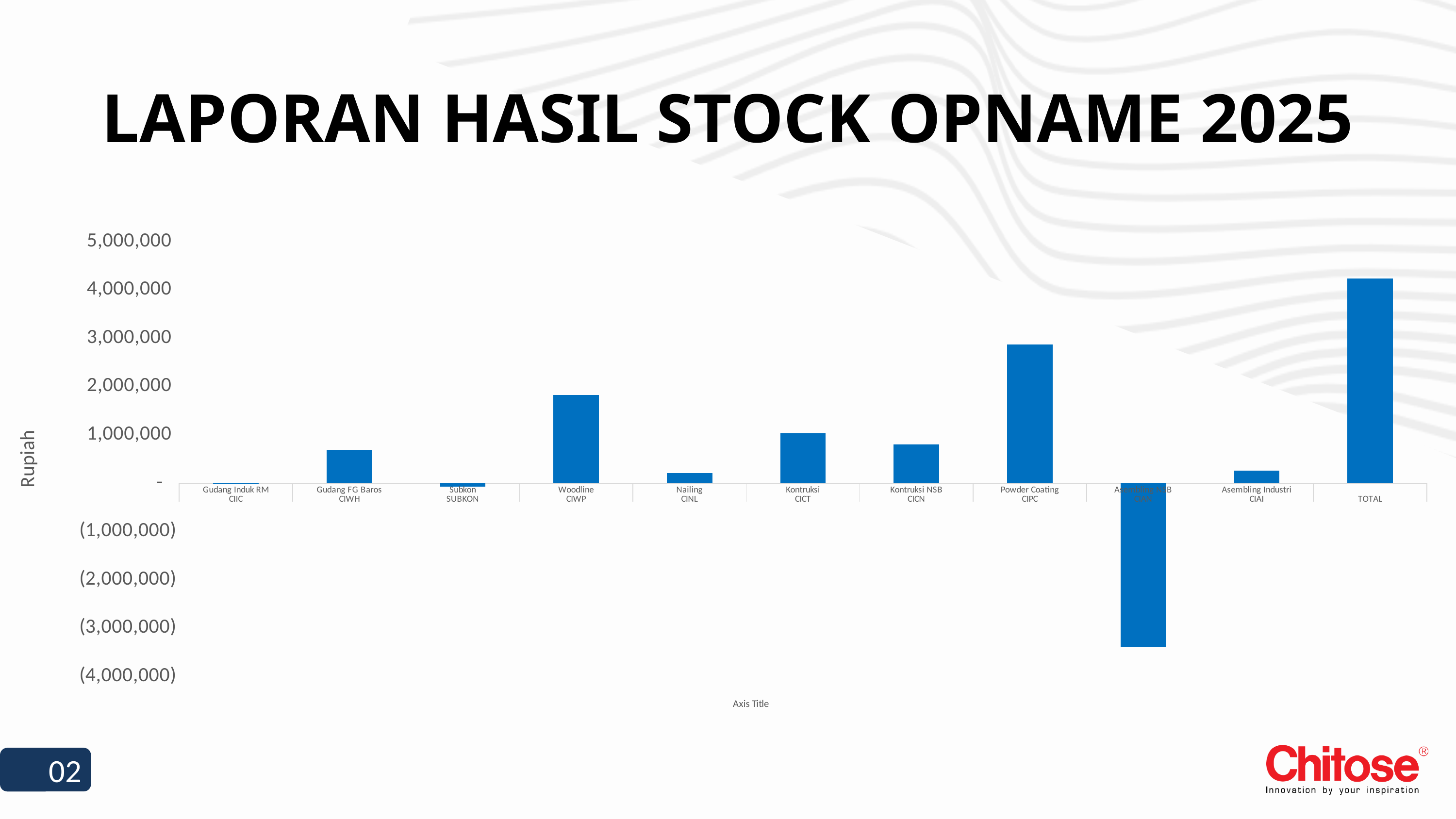
Is the value for Woodline CIWP greater or less than 2,000,000? less What is the title of the vertical axis of the chart? Rupiah What kind of chart is shown on the slide? bar chart Is the value for Gudang FG Baros CIWH greater or less than 1,000,000? less Is the value for Powder Coating CIPC greater or less than 2,000,000? greater Which is larger, the value for Kontruksi CICT or the value for Nailing CINL? Kontruksi CICT How many categories are plotted along the x axis of the chart? 11 Which is larger, the value for Powder Coating CIPC or the value for Woodline CIWP? Powder Coating CIPC Excluding TOTAL, which category has the highest bar? Powder Coating CIPC Which category has the lowest (most negative) bar in the chart? Asembling NSB Which category has the highest bar in the chart? TOTAL